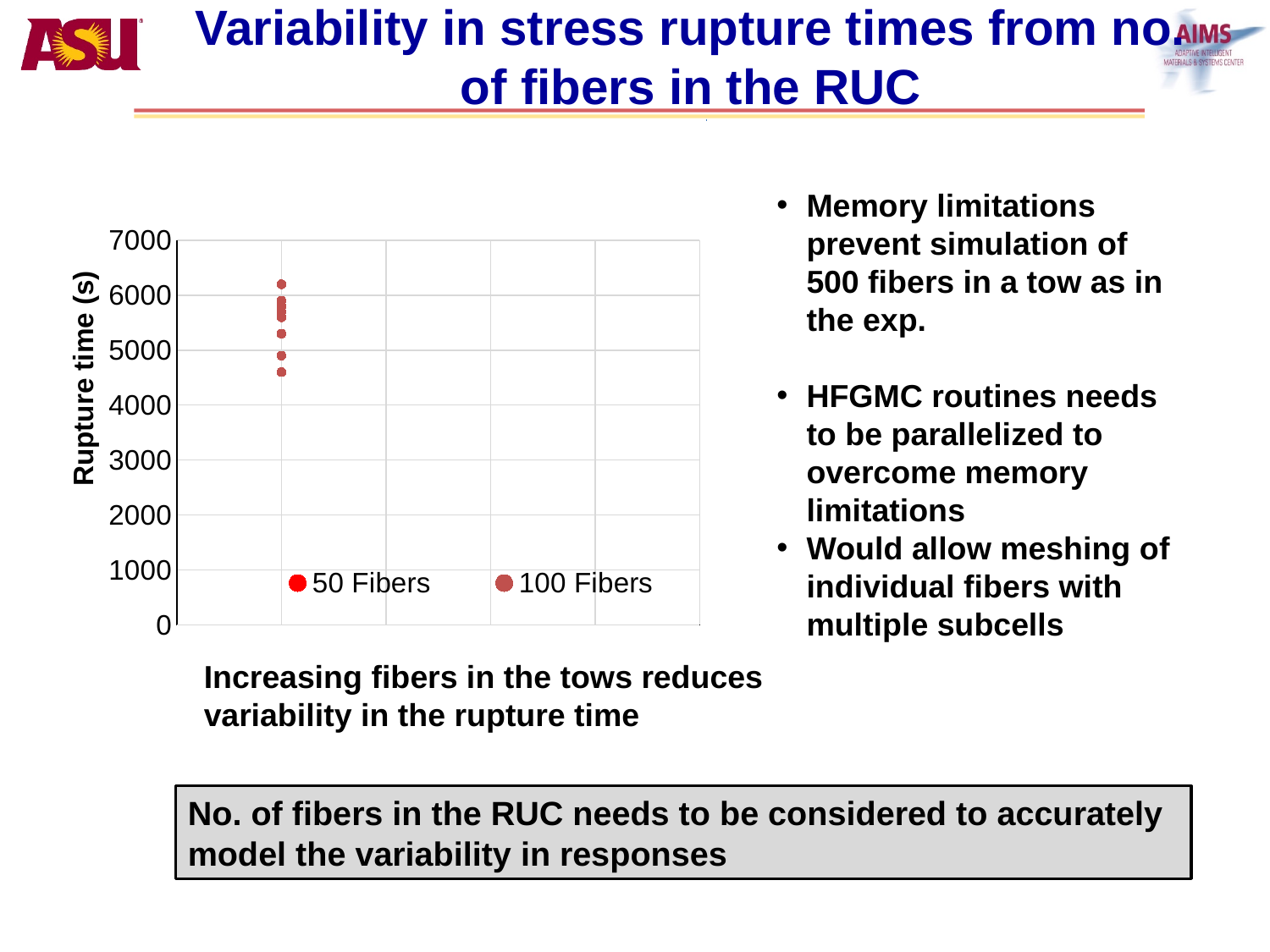
Are all the plotted rupture times greater or less than 4000? greater How many series does the chart legend list? 2 Is the highest plotted rupture time greater or less than 6000? greater What is the highest tick value shown on the vertical axis of the chart? 7000 Is the lowest plotted rupture time greater or less than 5000? less What are the two series named in the chart legend? 50 Fibers and 100 Fibers What kind of chart is shown on the slide? scatter chart What is the label of the vertical axis of the chart? Rupture time (s)